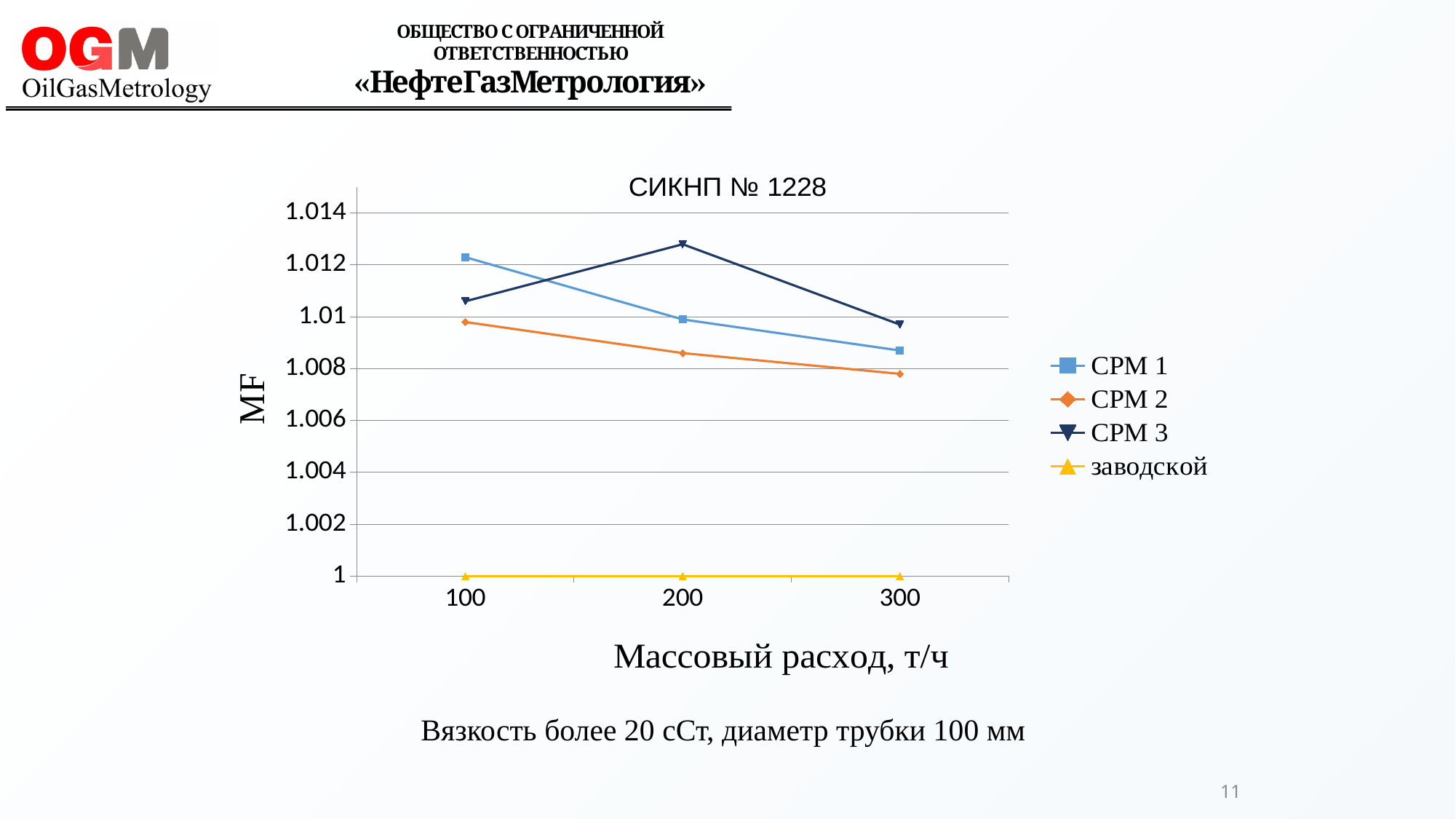
Is the MF value for CPM 2 at 300 т/ч greater or less than 1.008? less Which series has the highest MF value at a mass flow rate of 200 т/ч? CPM 3 What kind of chart is shown on the slide? line chart Does the MF value for CPM 2 rise or fall as mass flow rate increases from 100 to 300 т/ч? fall Which series has the highest MF value at a mass flow rate of 100 т/ч? CPM 1 How many mass flow rate points are plotted along the x axis? 3 Which series has the lowest MF values across all mass flow rates? заводской At a mass flow rate of 300 т/ч, which series has the larger MF value, CPM 1 or CPM 3? CPM 3 What is the MF value for the заводской series at a mass flow rate of 200 т/ч? 1 How many series does the legend list? 4 What is the title of the chart? СИКНП № 1228